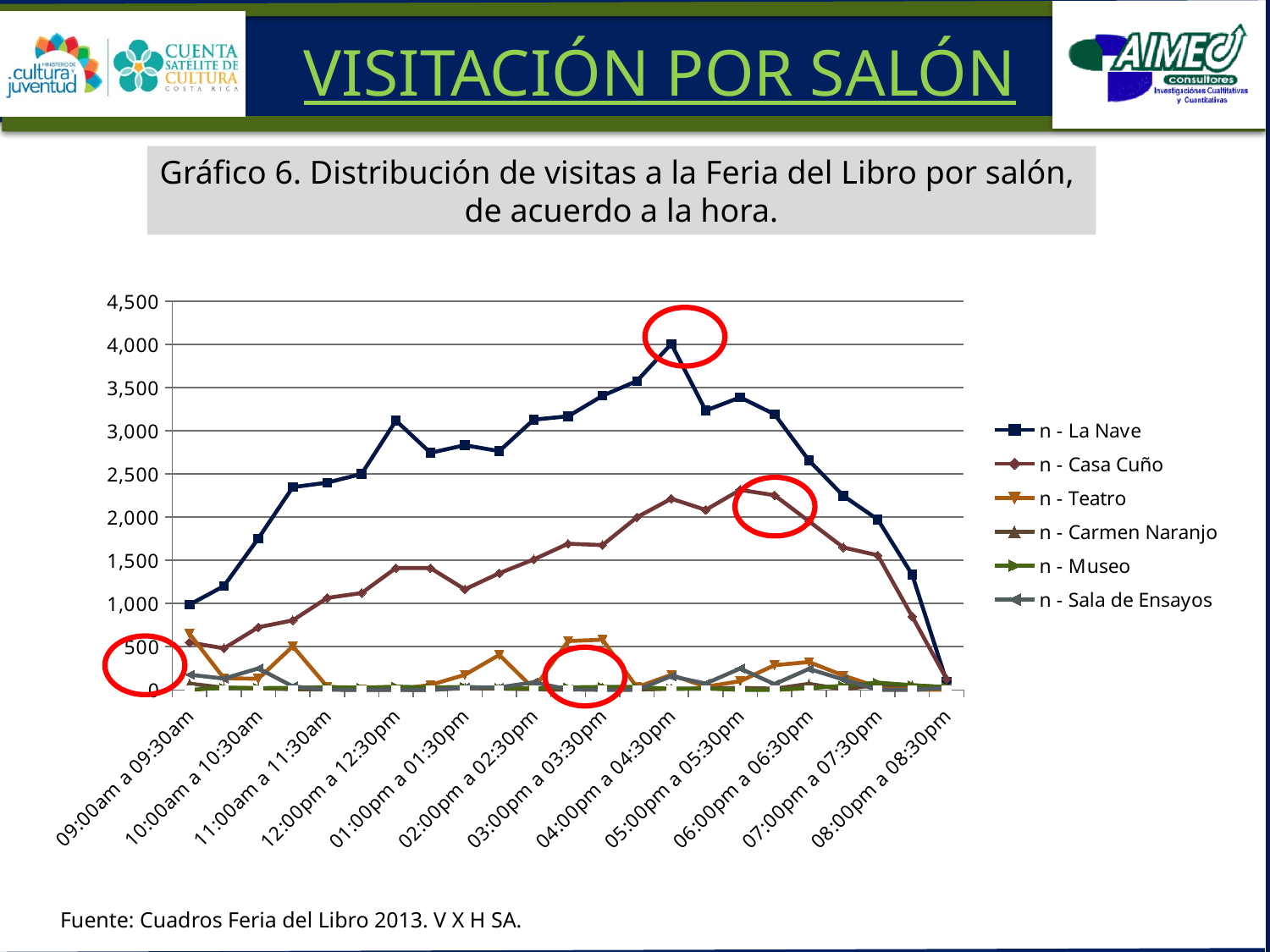
Which series reaches the highest value on the chart? n - La Nave What is the title of the chart? Gráfico 6. Distribución de visitas a la Feria del Libro por salón, de acuerdo a la hora. Is the value for n - La Nave at 03:00pm a 03:30pm greater or less than 3,000? greater Is the value for n - La Nave at 08:00pm a 08:30pm greater or less than 500? less Is the value for n - La Nave at 10:00am a 10:30am greater or less than 1,500? greater How many series does the legend list? 6 Does the n - La Nave series rise or fall between 04:00pm a 04:30pm and 08:00pm a 08:30pm? fall At 04:00pm a 04:30pm, which is larger: n - La Nave or n - Casa Cuño? n - La Nave What kind of chart is shown on the slide? line chart Which series has the second-highest peak on the chart? n - Casa Cuño